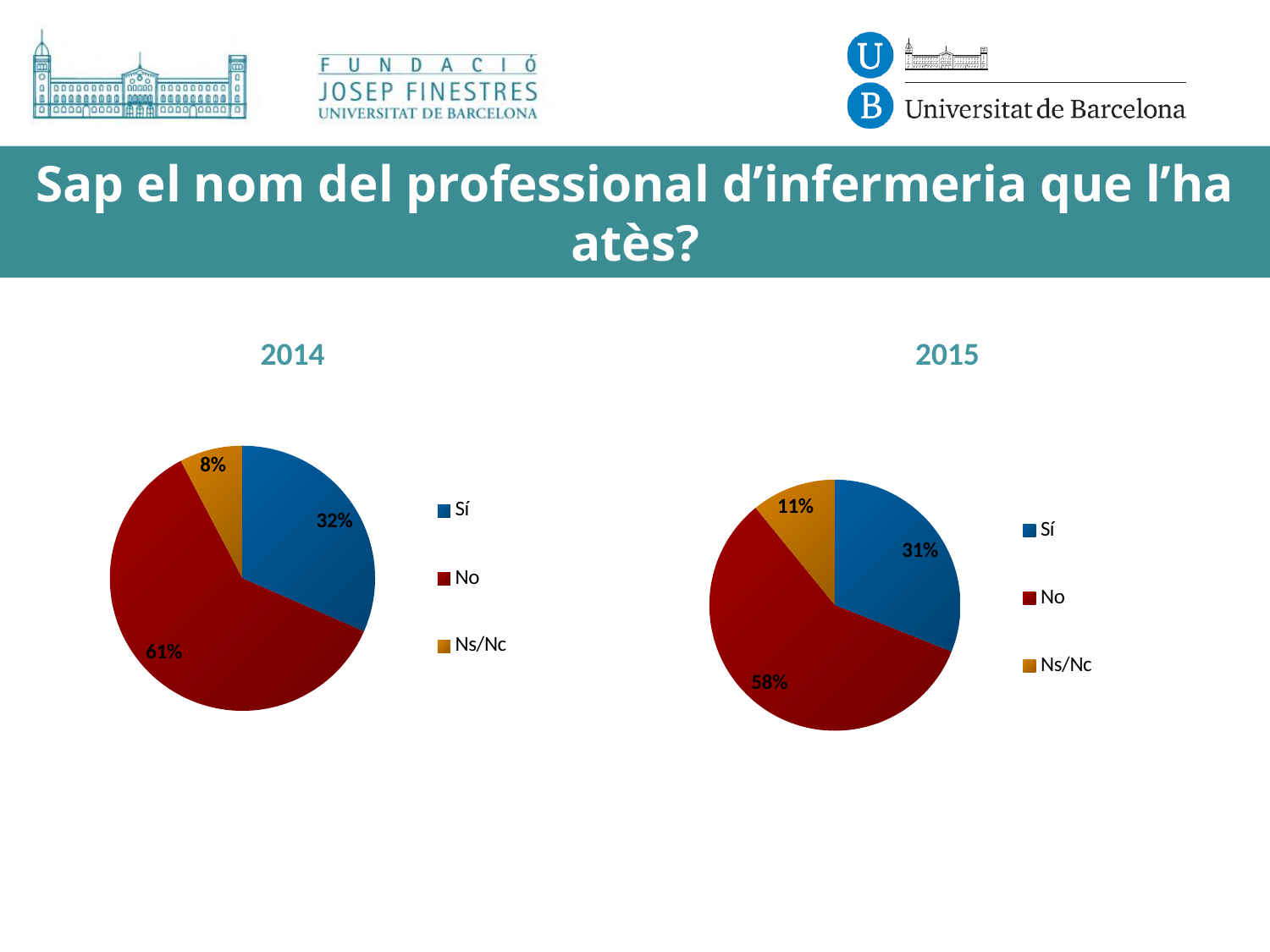
In the 2015 pie chart, what percentage is shown for "Sí"? 31% In the 2015 pie chart, what percentage is shown for "Ns/Nc"? 11% Which is larger: the "Ns/Nc" share in the 2014 chart or in the 2015 chart? 2015 In the 2015 pie chart, what is the difference between the "No" and "Ns/Nc" percentages? 47% In the 2014 pie chart, which category has the smallest slice? Ns/Nc How many categories does the 2014 pie chart show? 3 What type of chart is used for the 2015 data? Pie chart In the 2014 pie chart, what is the difference between the "No" and "Sí" percentages? 29% In the 2014 pie chart, what percentage is shown for "Ns/Nc"? 8% In the 2014 pie chart, what percentage is shown for "No"? 61% In the 2015 pie chart, what colour represents "No"? Red In the 2015 pie chart, which category has the largest slice? No